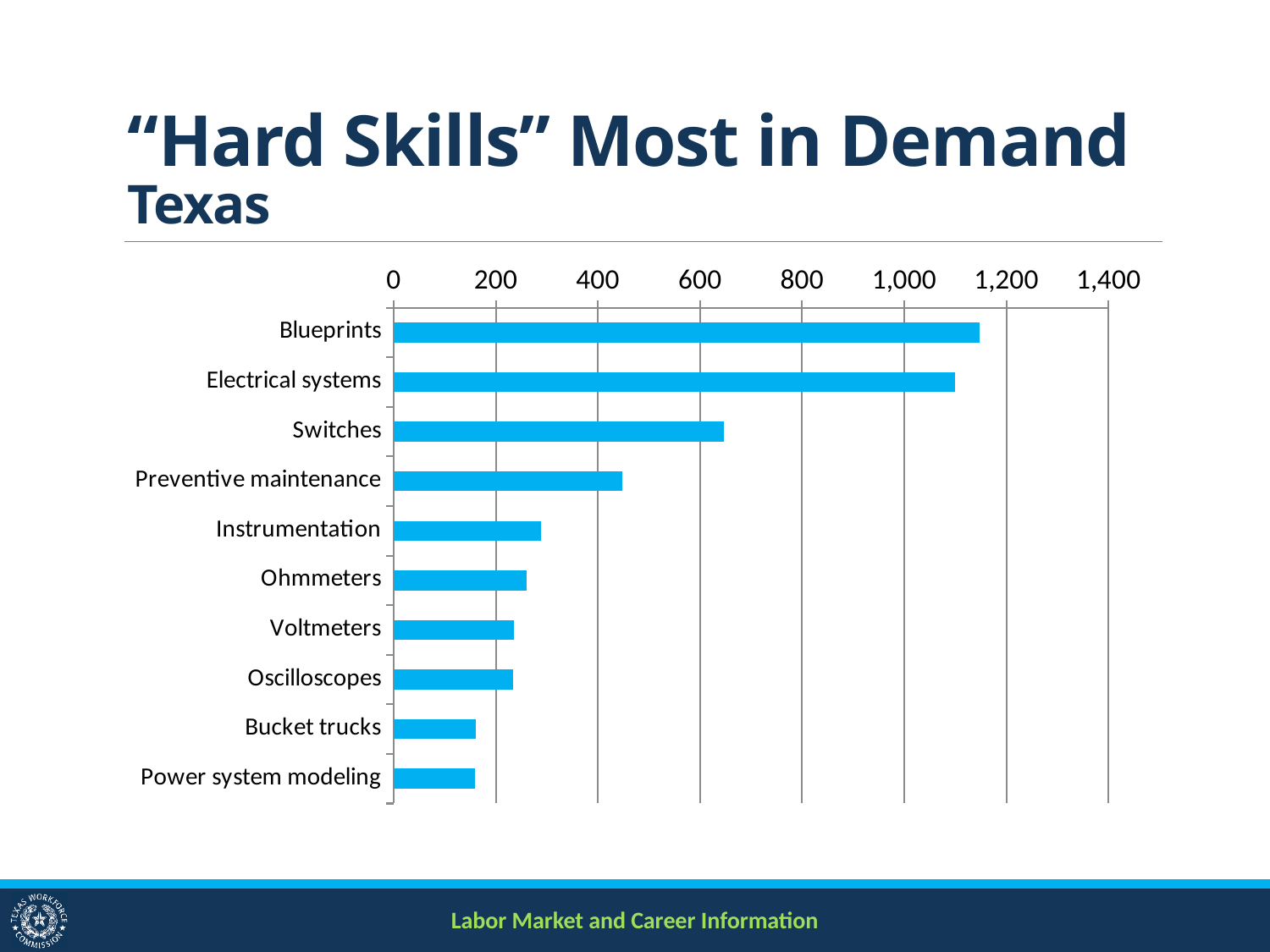
Is the value for Blueprints greater or less than 1,000? greater Is the value for Bucket trucks greater or less than 200? less Which skill has the highest value in the chart? Blueprints Which has a larger value, Instrumentation or Oscilloscopes? Instrumentation Is the value for Electrical systems greater or less than 1,000? greater What is the highest value shown on the chart's horizontal axis? 1,400 What kind of chart is shown on the slide? bar chart How many skill categories are plotted in the chart? 10 Which has a larger value, Switches or Preventive maintenance? Switches